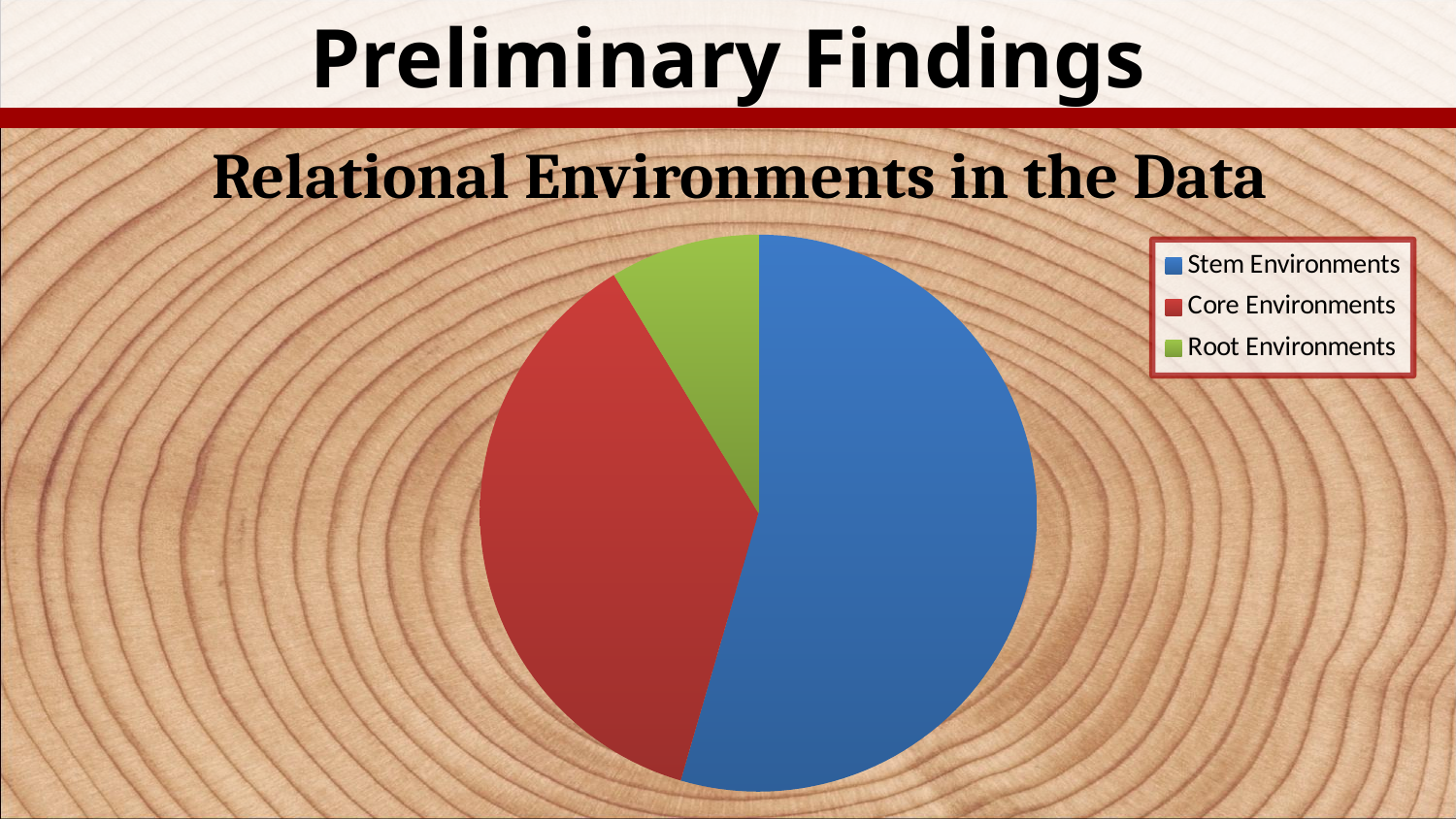
Which slice is larger, Core Environments or Root Environments? Core Environments How many entries does the legend list? 3 How many slices does the pie chart have? 3 What kind of chart is shown on the slide? Pie chart What is the title of the chart? Relational Environments in the Data Which category has the smallest slice of the pie? Root Environments Which category has the largest slice of the pie? Stem Environments Which slice is larger, Stem Environments or Core Environments? Stem Environments What colour represents Core Environments in the pie chart? Red